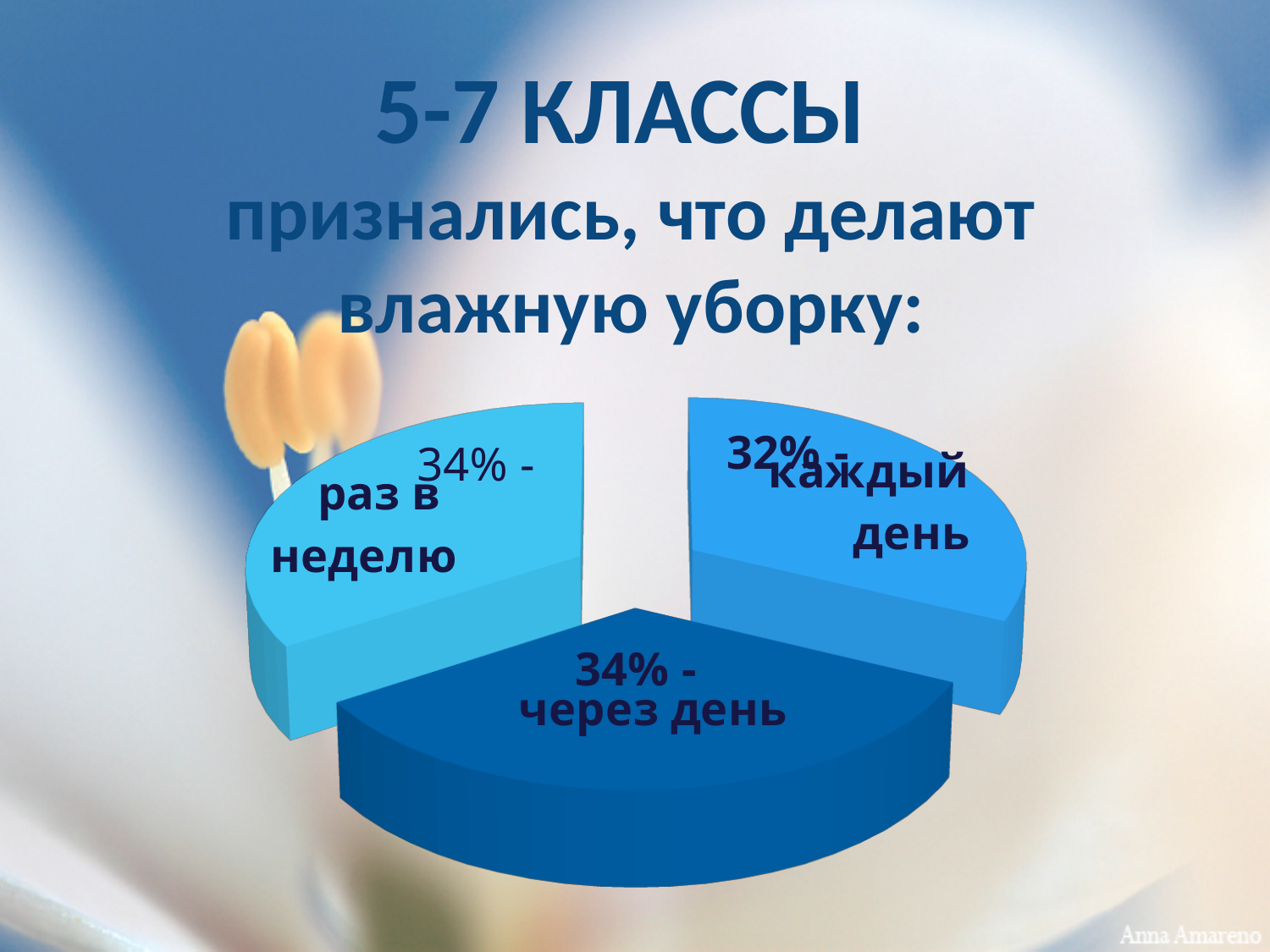
By how many percentage points does the 'через день' share exceed the 'каждый день' share? 2 What percentage of 5-7 grade students said they do wet cleaning once a week (раз в неделю)? 34% Do the 'раз в неделю' and 'через день' slices have the same value? yes What percentage of 5-7 grade students said they do wet cleaning every day (каждый день)? 32% What is the title of the slide containing the pie chart? 5-7 КЛАССЫ признались, что делают влажную уборку: How many slices does the pie chart have? 3 Which is larger: the share for 'раз в неделю' or the share for 'каждый день'? раз в неделю What kind of chart is shown on the slide? pie chart What is the total of the three percentages shown on the pie chart? 100% Which slice of the pie chart is drawn in the darkest blue? через день Which slice of the pie chart is the smallest? каждый день What percentage of 5-7 grade students said they do wet cleaning every other day (через день)? 34%